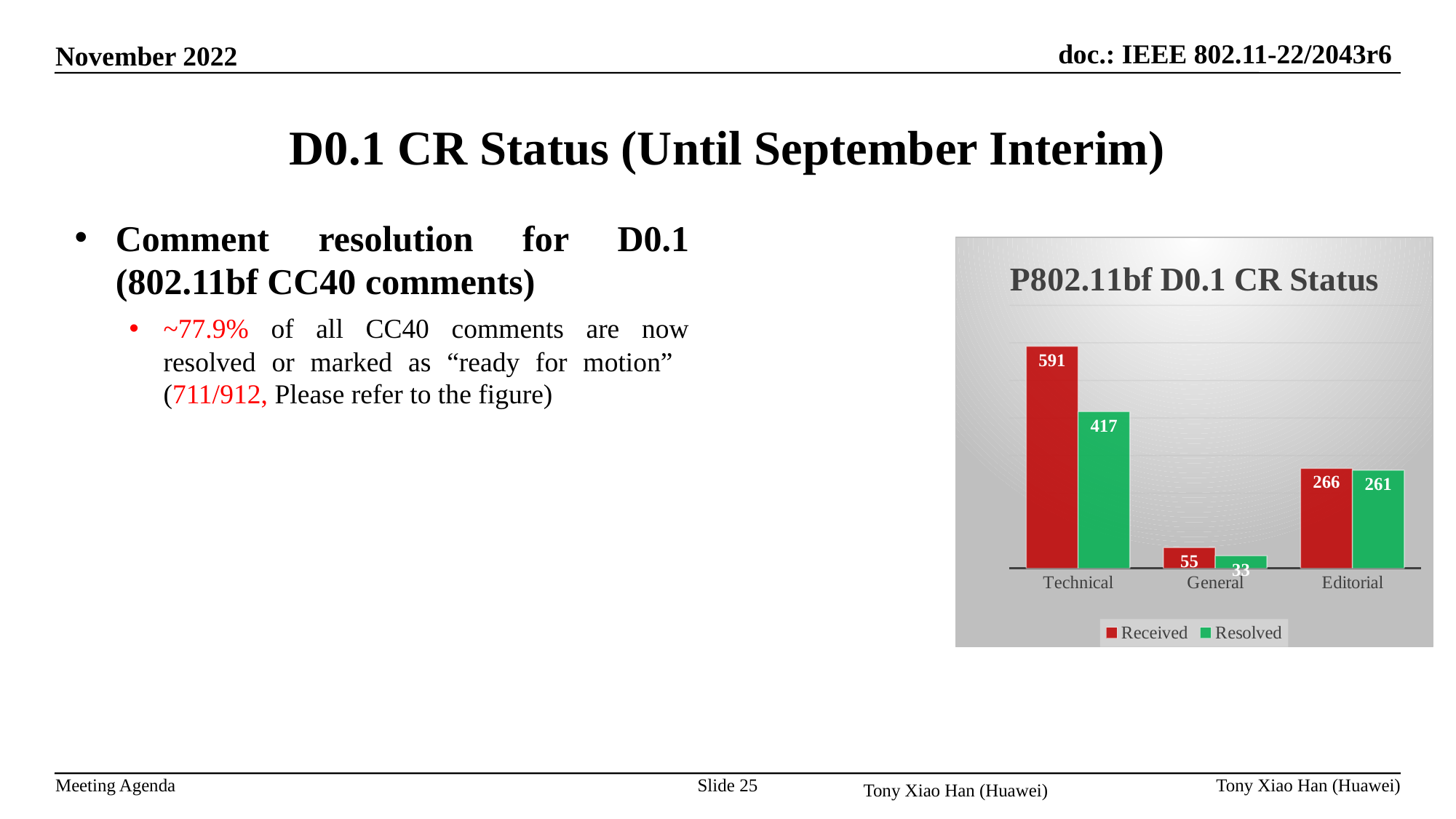
What kind of chart is shown on the slide? Bar chart Which category has the highest Received value? Technical What is the Resolved value for General? 33 Which category has the lowest Resolved value? General What is the difference between Received and Resolved for General? 22 How many categories are shown on the x axis? 3 What is the Resolved value for Editorial? 261 What is the difference between Received and Resolved for Technical? 174 What is the title of the chart? P802.11bf D0.1 CR Status How many series does the legend list? 2 Which is larger, the Received value for Editorial or the Resolved value for Technical? Resolved value for Technical What is the Received value for Technical? 591